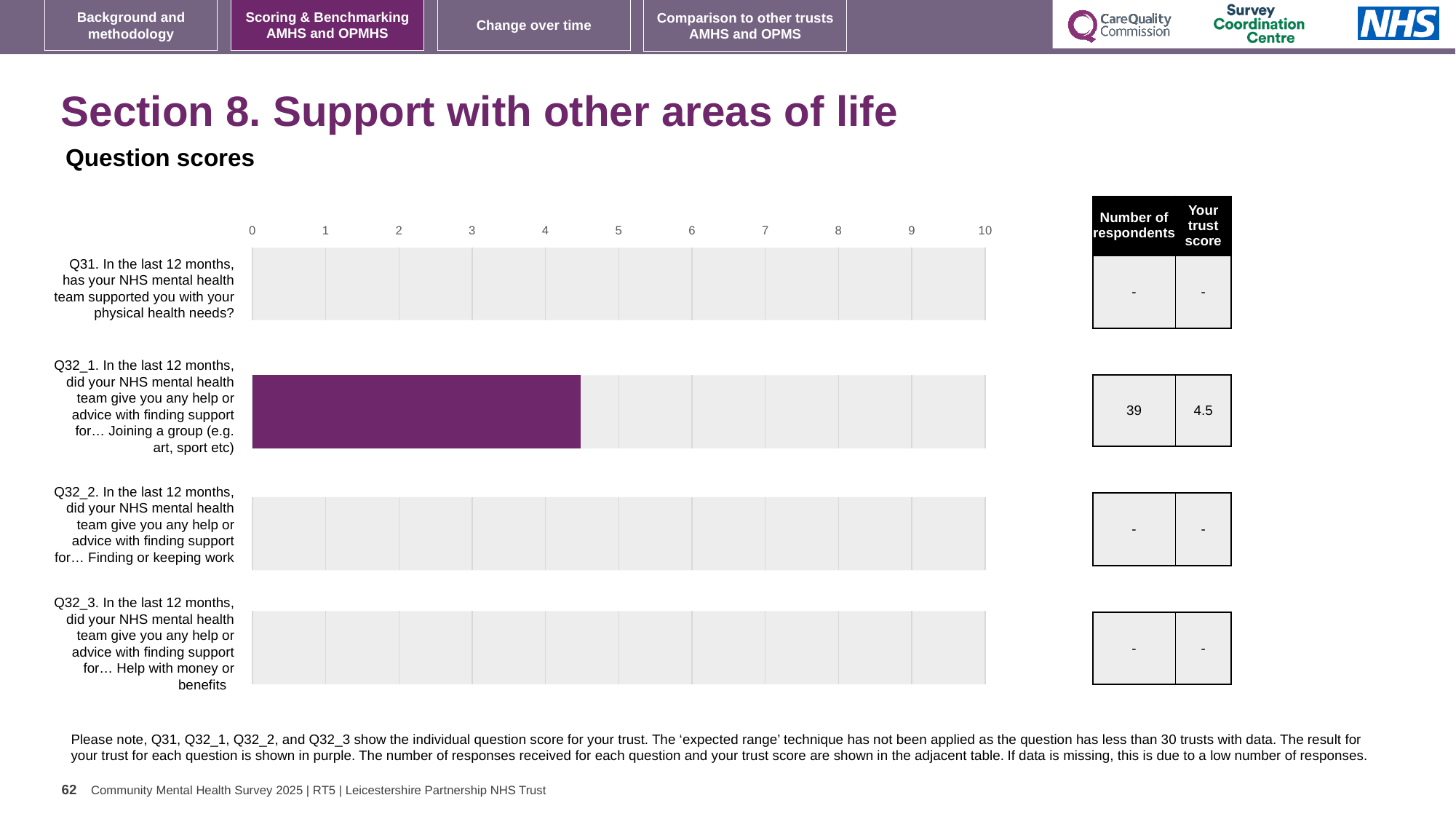
What colour is the bar representing the trust's result for Q32_1? purple What is the trust score for Q32_1 (help or advice with finding support for joining a group)? 4.5 What is the number of respondents shown in the table for Q32_3? - What is the trust score shown in the table for Q31? - How many questions (categories) are listed on the chart? 4 Which question is the only one with a plotted bar on the chart? Q32_1 Is the trust score for Q32_1 greater or less than 5? less Is the trust score for Q32_1 greater or less than 4? greater What kind of chart is used to show the question scores on this slide? bar chart How many respondents answered Q32_1 according to the adjacent table? 39 What is the maximum value shown on the chart's x axis? 10